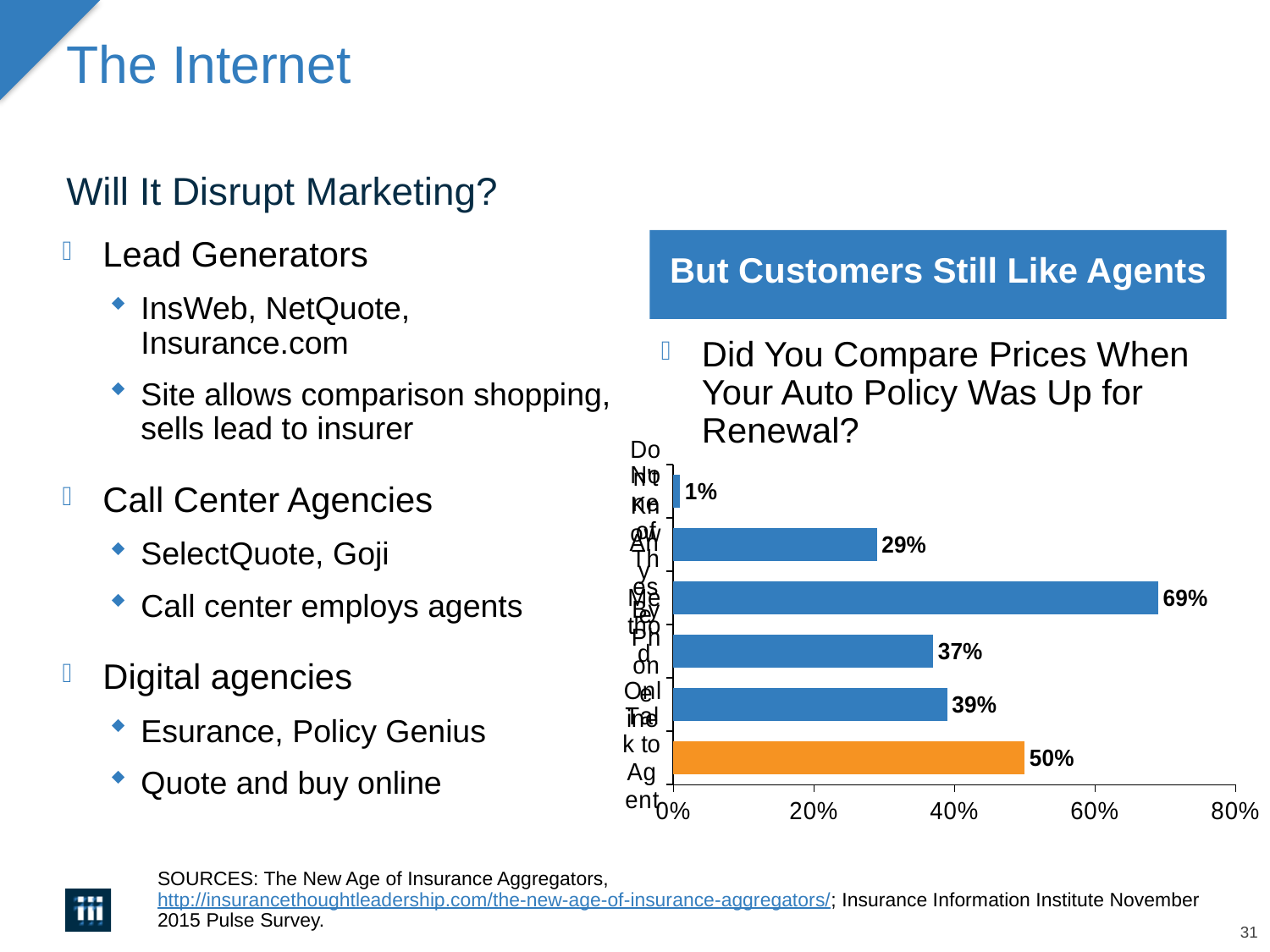
What is the value of the top bar in the chart? 1% How many bars are plotted in the chart? 6 What is the difference between the longest bar (69%) and the bottom bar (50%)? 19% What is the lowest value shown in the chart? 1% Is the value of the second bar from the top greater or less than 40%? less Which is larger, the fourth bar from the top (37%) or the fifth bar from the top (39%)? 39% Which bar is coloured orange rather than blue? the bottom bar (50%) What kind of chart is shown on the slide? bar chart What is the value of the third bar from the top in the chart? 69% What is the heading in the blue box above the chart? But Customers Still Like Agents What is the highest value shown in the chart? 69% What is the value of the bottom bar in the chart? 50%